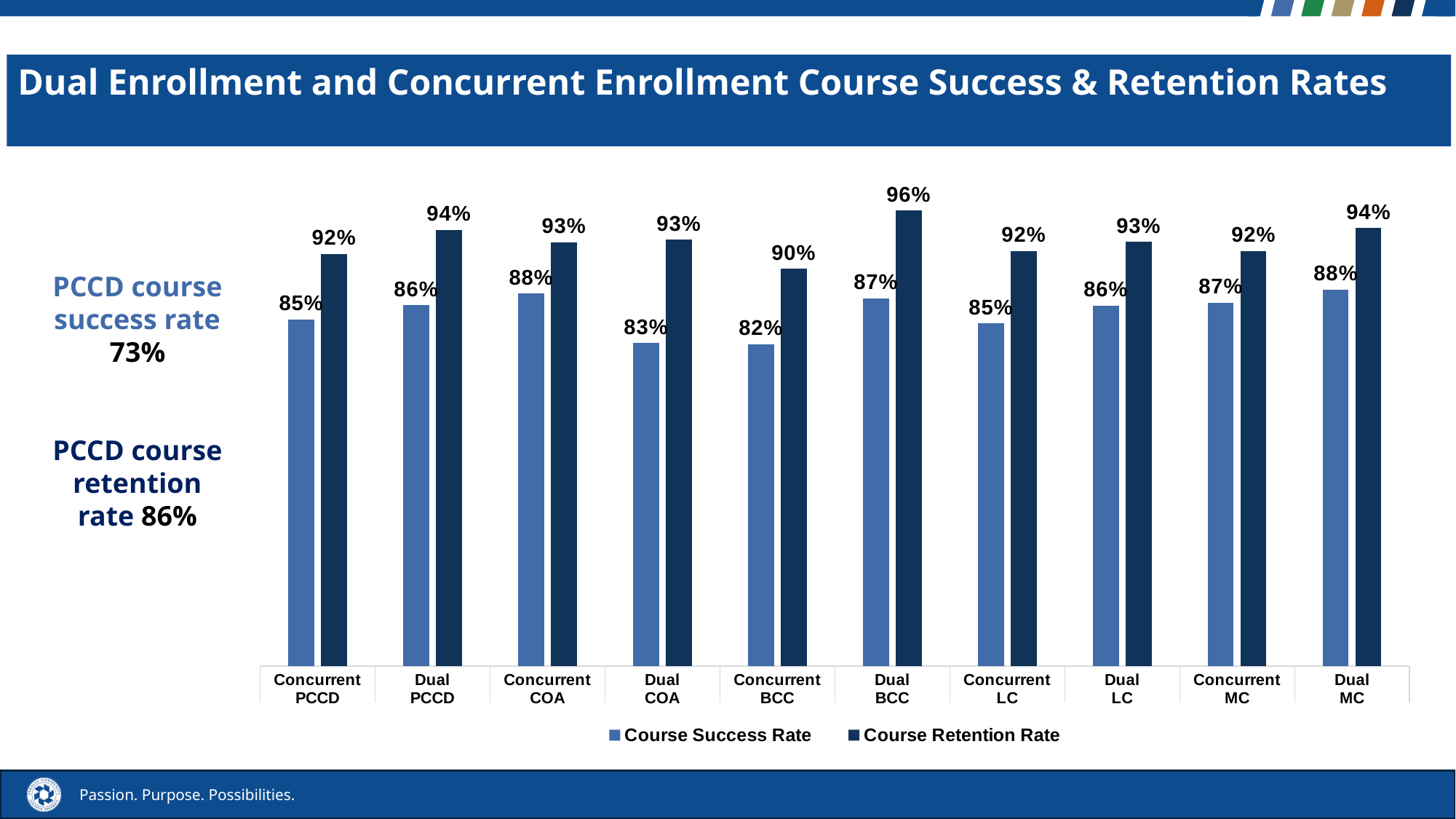
How many series does the legend list? 2 Which category has the lowest Course Success Rate? Concurrent BCC What is the difference between the Course Retention Rate and the Course Success Rate for Dual PCCD? 8% What is the Course Retention Rate for Dual BCC? 96% What kind of chart is shown on the slide? Bar chart Which is larger, the Course Success Rate for Concurrent COA or for Concurrent LC? Concurrent COA Which category has the highest Course Retention Rate? Dual BCC What is the Course Success Rate for Concurrent PCCD? 85% What is the Course Retention Rate for Concurrent BCC? 90% What is the title of the slide? Dual Enrollment and Concurrent Enrollment Course Success & Retention Rates What is the Course Success Rate for Dual COA? 83% How many categories are shown on the x axis? 10